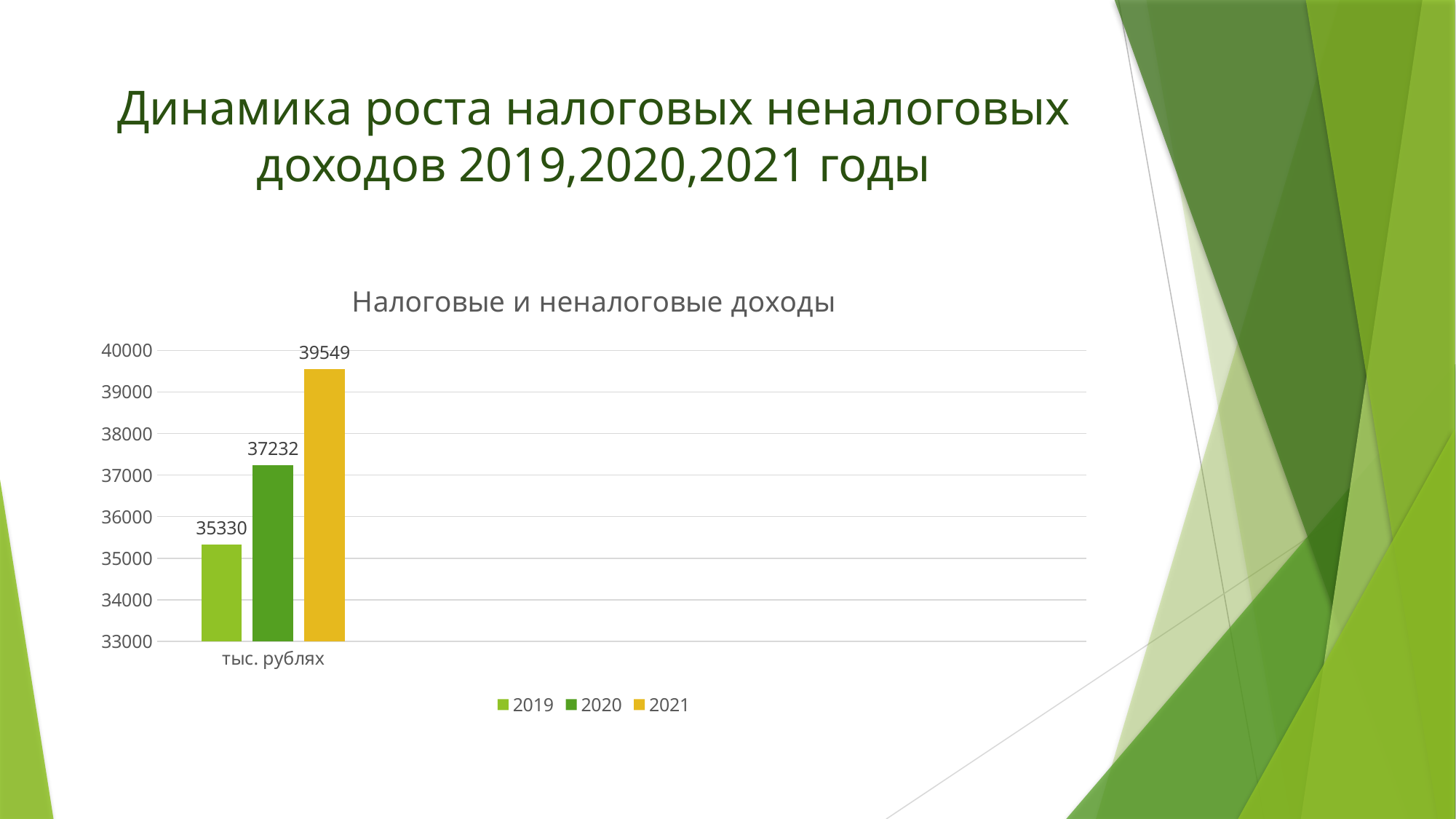
Which year has the highest value? 2021 Which year has the lowest value? 2019 What is the title of the chart? Налоговые и неналоговые доходы What is the difference between the 2020 and 2019 values? 1902 What kind of chart is shown on the slide? bar chart What is the value for 2019 in the chart? 35330 What is the difference between the 2021 and 2019 values? 4219 How many series does the legend list? 3 What is the value for 2021 in the chart? 39549 Is the value for 2019 greater or less than 36000? less What is the value for 2020 in the chart? 37232 Which is larger, the value for 2020 or the value for 2021? 2021